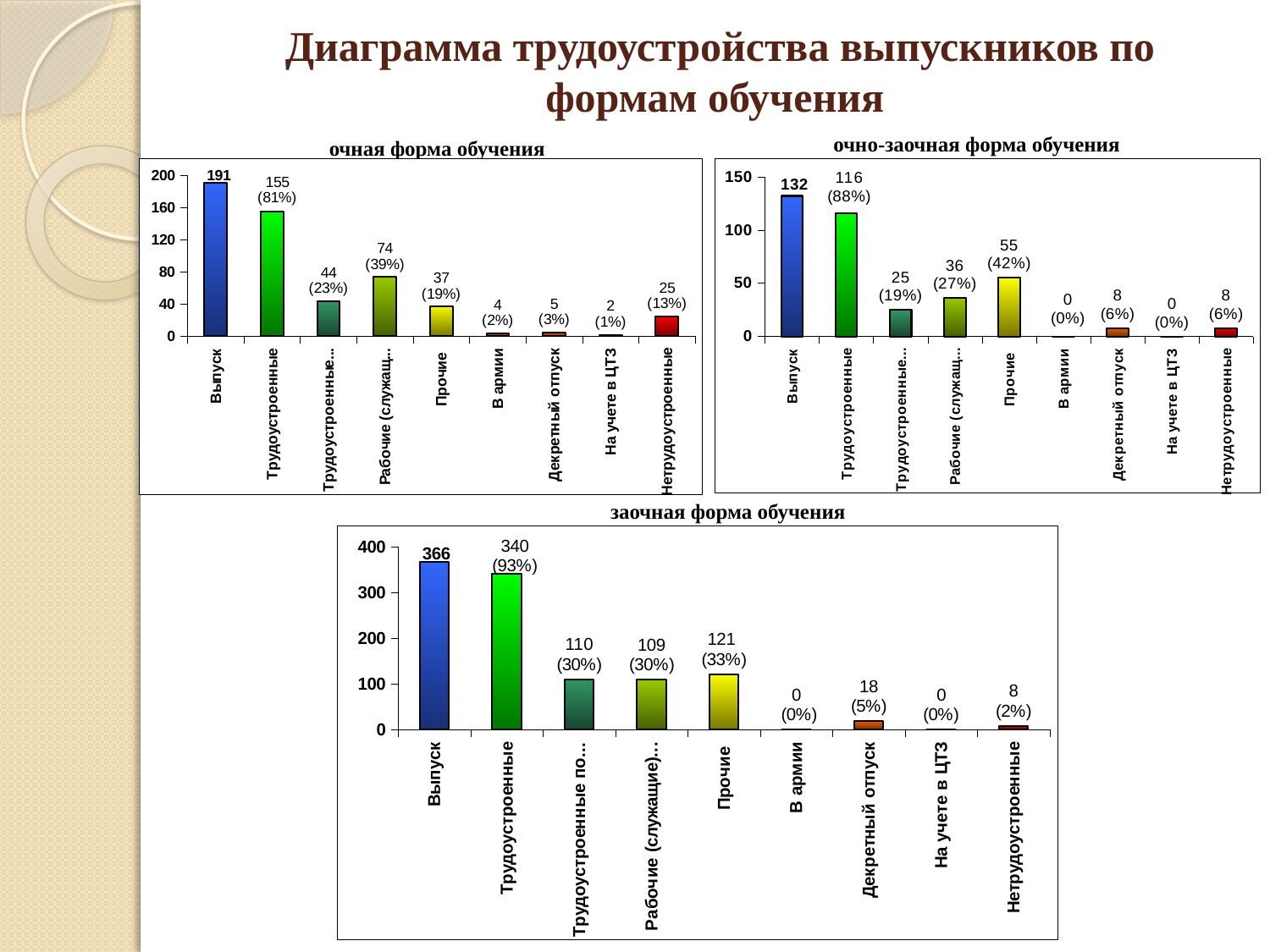
How many charts are shown on the slide? 3 In the chart titled "очная форма обучения", which category has the lowest value? На учете в ЦТЗ In the chart titled "заочная форма обучения", which category has the highest value? Выпуск What type of chart is the one titled "заочная форма обучения"? Bar chart In the chart titled "очно-заочная форма обучения", what is the difference between Выпуск and Трудоустроенные? 16 In the chart titled "очная форма обучения", what is the value for Выпуск? 191 In the chart titled "очная форма обучения", what is the difference between Выпуск and Трудоустроенные? 36 How many categories are shown in the chart titled "очно-заочная форма обучения"? 9 In the chart titled "очно-заочная форма обучения", what is the value for Прочие? 55 In the chart titled "очная форма обучения", what is the value for Нетрудоустроенные? 25 In the chart titled "заочная форма обучения", what percentage is shown for Трудоустроенные? 93% In the chart titled "заочная форма обучения", which is larger: Прочие or Декретный отпуск? Прочие